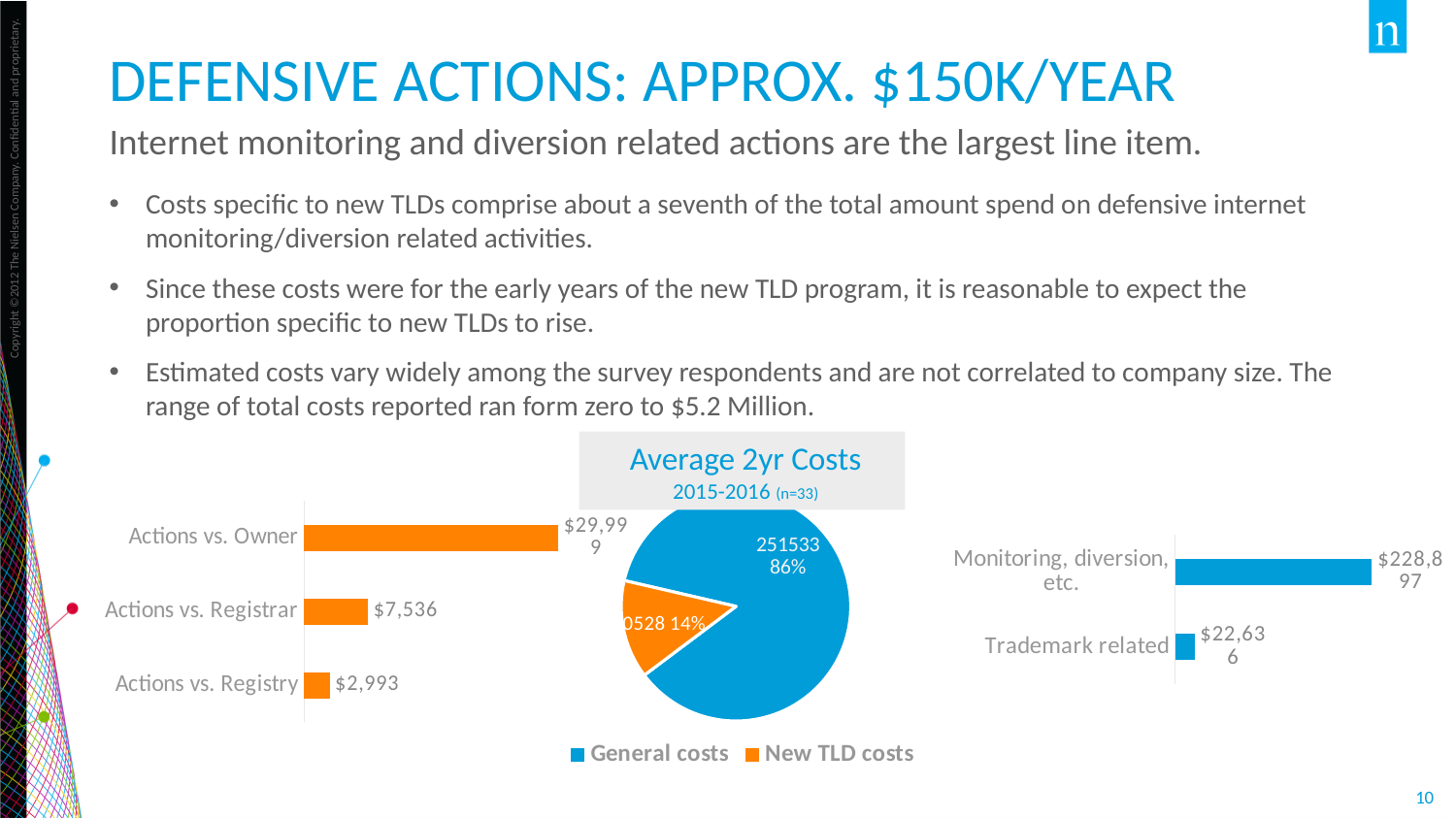
In the right bar chart, what is the difference between Monitoring, diversion, etc. and Trademark related? $206,261 In the right bar chart, what is the value for Monitoring, diversion, etc.? $228,897 In the right bar chart, what is the value for Trademark related? $22,636 In the left bar chart, how many categories are shown? 3 In the left bar chart, what is the value for Actions vs. Registrar? $7,536 In the pie chart titled Average 2yr Costs, what share do New TLD costs represent? 14% In the left bar chart, what is the value for Actions vs. Owner? $29,999 In the right bar chart, which category is larger: Monitoring, diversion, etc. or Trademark related? Monitoring, diversion, etc. In the left bar chart, what is the difference between Actions vs. Owner and Actions vs. Registrar? $22,463 In the left bar chart, which category has the lowest value? Actions vs. Registry In the pie chart titled Average 2yr Costs, what share do General costs represent? 86% How many series does the legend below the pie chart list? 2